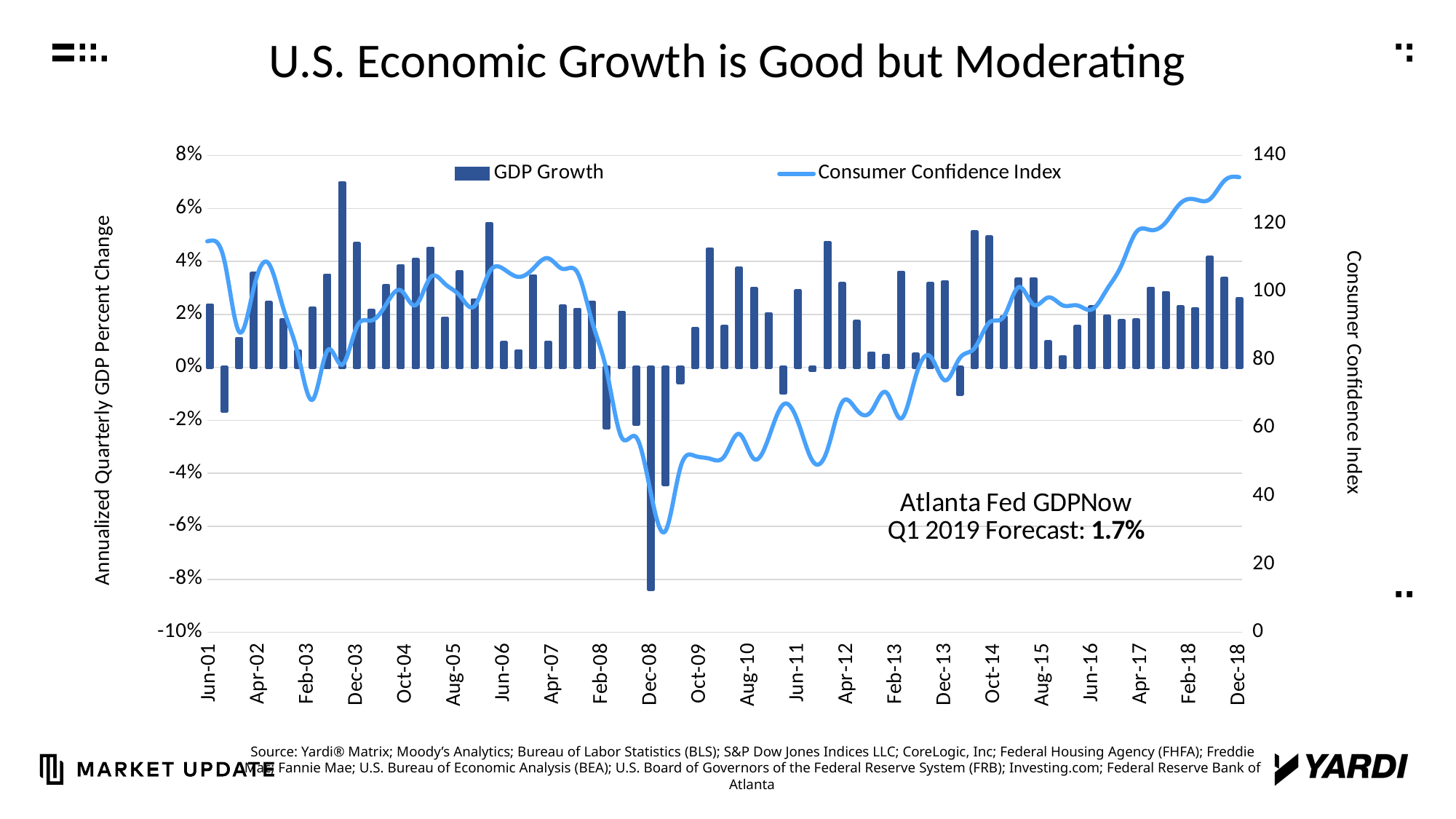
What is the title of the chart? U.S. Economic Growth is Good but Moderating What are the two series named in the legend? GDP Growth and Consumer Confidence Index Which series is plotted as bars? GDP Growth How many series does the legend list? 2 Is the GDP Growth value at Dec-08 greater or less than -6%? less Is the Consumer Confidence Index value at Dec-18 greater or less than 120? greater Around which x-axis label does the GDP Growth series reach its lowest bar? Dec-08 Is the Consumer Confidence Index value at Jun-11 greater or less than 80? less Which is higher, the Consumer Confidence Index at Dec-18 or at Dec-08? Dec-18 What kind of chart is shown on the slide? A combination bar and line chart Does the Consumer Confidence Index generally rise or fall from Dec-08 to Dec-18? rise